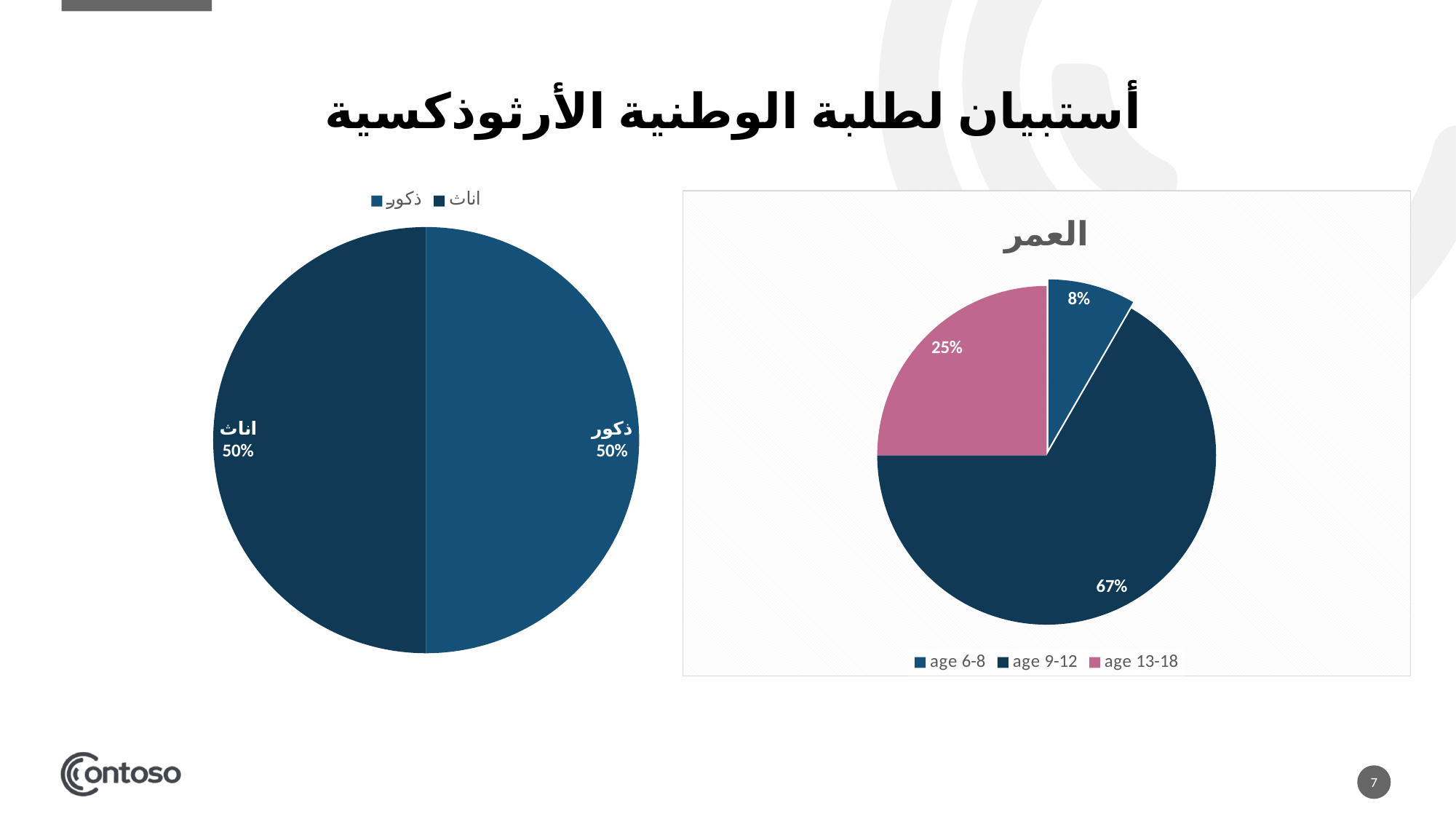
How many slices does the pie chart titled العمر on the right have? 3 In the pie chart on the left, what share is labelled for ذكور? 50% In the pie chart titled العمر on the right, which age group has the smallest slice? age 6-8 What type of chart is shown on the left of the slide? Pie chart In the pie chart titled العمر on the right, what is the difference in percentage points between age 9-12 and age 13-18? 42 How many entries does the legend of the pie chart on the left list? 2 In the pie chart titled العمر on the right, which age group has the largest slice? age 9-12 In the pie chart titled العمر on the right, which is larger, the slice for age 13-18 or the slice for age 6-8? age 13-18 In the pie chart titled العمر on the right, what share is labelled for age 9-12? 67% In the pie chart on the left, what share is labelled for اناث? 50% In the pie chart titled العمر on the right, what share is labelled for age 13-18? 25% In the pie chart titled العمر on the right, what share is labelled for age 6-8? 8%